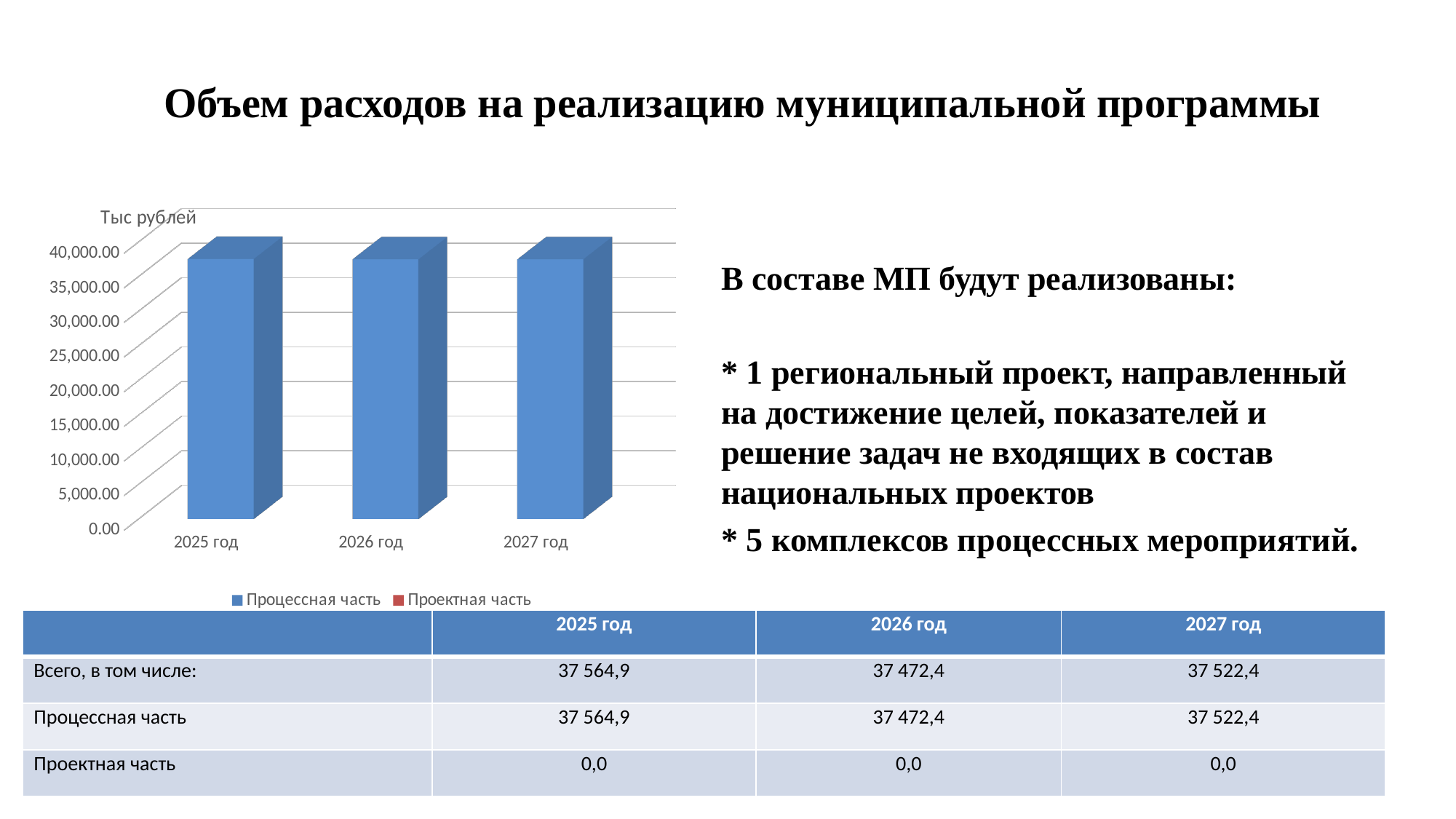
According to the table under the chart, what is the value of Процессная часть for 2026 год? 37 472,4 According to the table under the chart, what is the value of Процессная часть for 2025 год? 37 564,9 According to the table under the chart, what is the value of Проектная часть for 2027 год? 0,0 What kind of chart is shown on the slide? bar chart Is the value of the bar for 2027 год greater or less than 30,000.00? greater What unit label is shown above the vertical axis of the chart? Тыс рублей How many year categories are shown on the x axis of the chart? 3 Is the value of the bar for 2025 год greater or less than 40,000.00? less Is the value of the bar for 2026 год greater or less than 35,000.00? greater How many series does the chart legend list? 2 Which series in the legend is shown in blue? Процессная часть